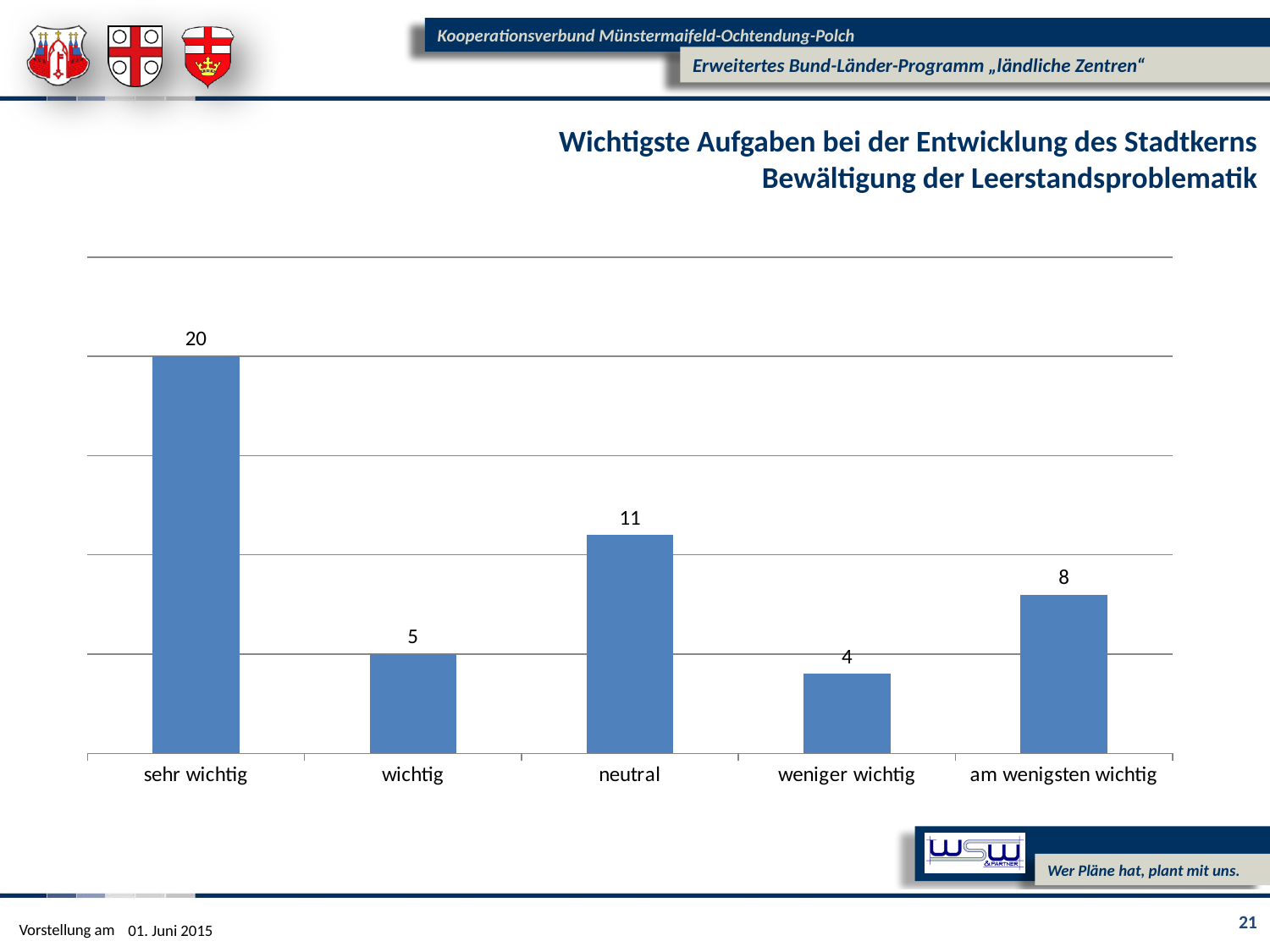
Which category has the highest value? sehr wichtig What is the value for "wichtig"? 5 What is the difference between the values for "am wenigsten wichtig" and "weniger wichtig"? 4 What is the value for "neutral"? 11 Which category has the lowest value? weniger wichtig What is the value for "sehr wichtig"? 20 What kind of chart is shown on the slide? bar chart Which is larger, the value for "wichtig" or the value for "am wenigsten wichtig"? am wenigsten wichtig How many categories are shown on the x axis? 5 What is the second line of the chart's title? Bewältigung der Leerstandsproblematik What is the difference between the values for "sehr wichtig" and "neutral"? 9 What is the value for "am wenigsten wichtig"? 8